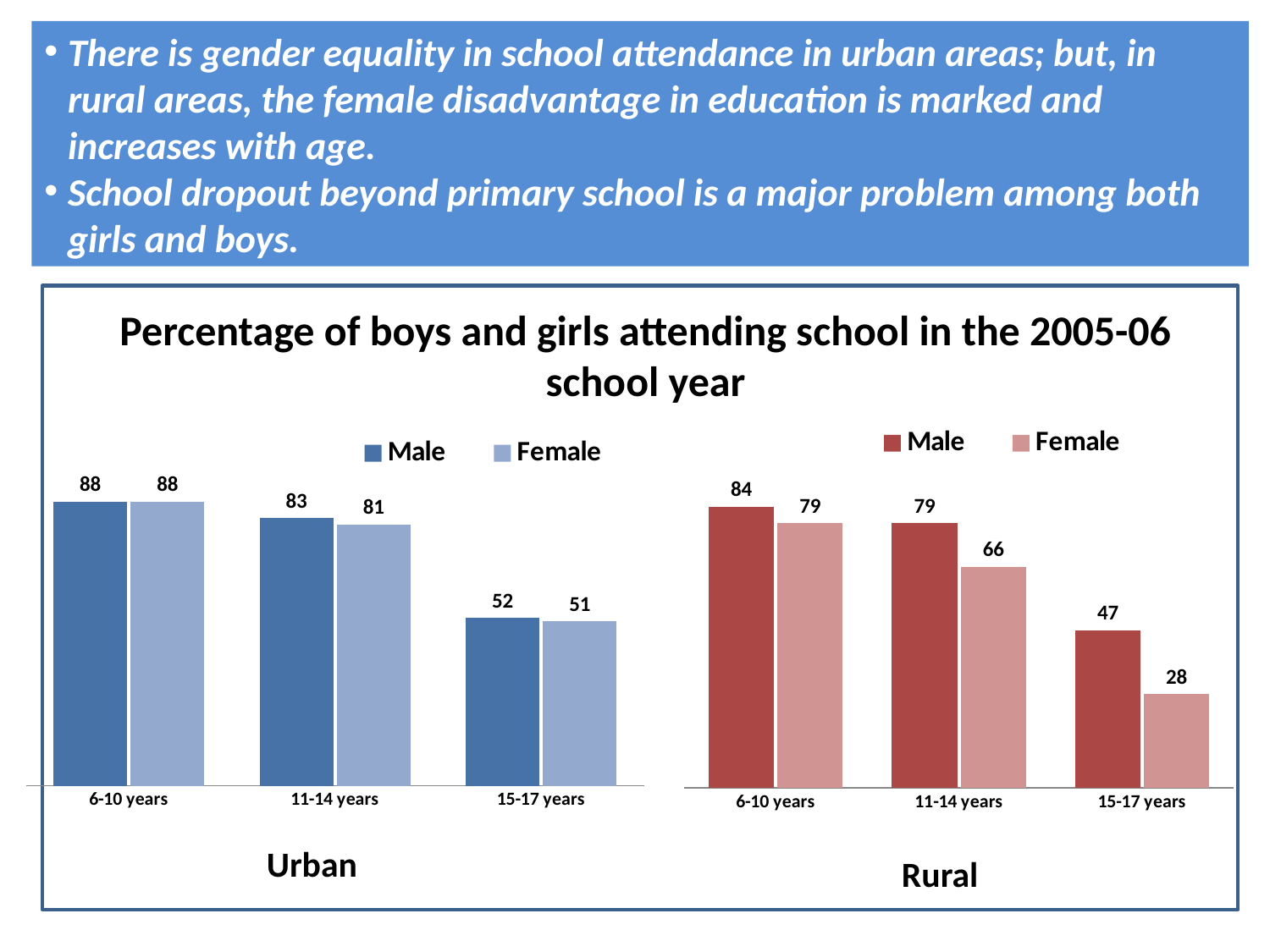
How many series does the legend of the Rural chart list? 2 In the Rural chart, which age group has the lowest Female value? 15-17 years In the Urban chart, which age group has the highest Male value? 6-10 years In the Rural chart, what is the difference between the Male and Female values for the 11-14 years group? 13 In the Urban chart, what is the value for Female in the 11-14 years group? 81 In the Rural chart, what is the value for Male in the 11-14 years group? 79 In the Urban chart, what is the value for Male in the 6-10 years group? 88 In the Rural chart, what is the difference between the Male and Female values for the 15-17 years group? 19 What type of chart is the Urban chart? Bar chart In the Rural chart, what is the value for Female in the 15-17 years group? 28 How many age groups are shown in the Urban chart? 3 In the Rural chart, which is larger for the 6-10 years group, Male or Female? Male